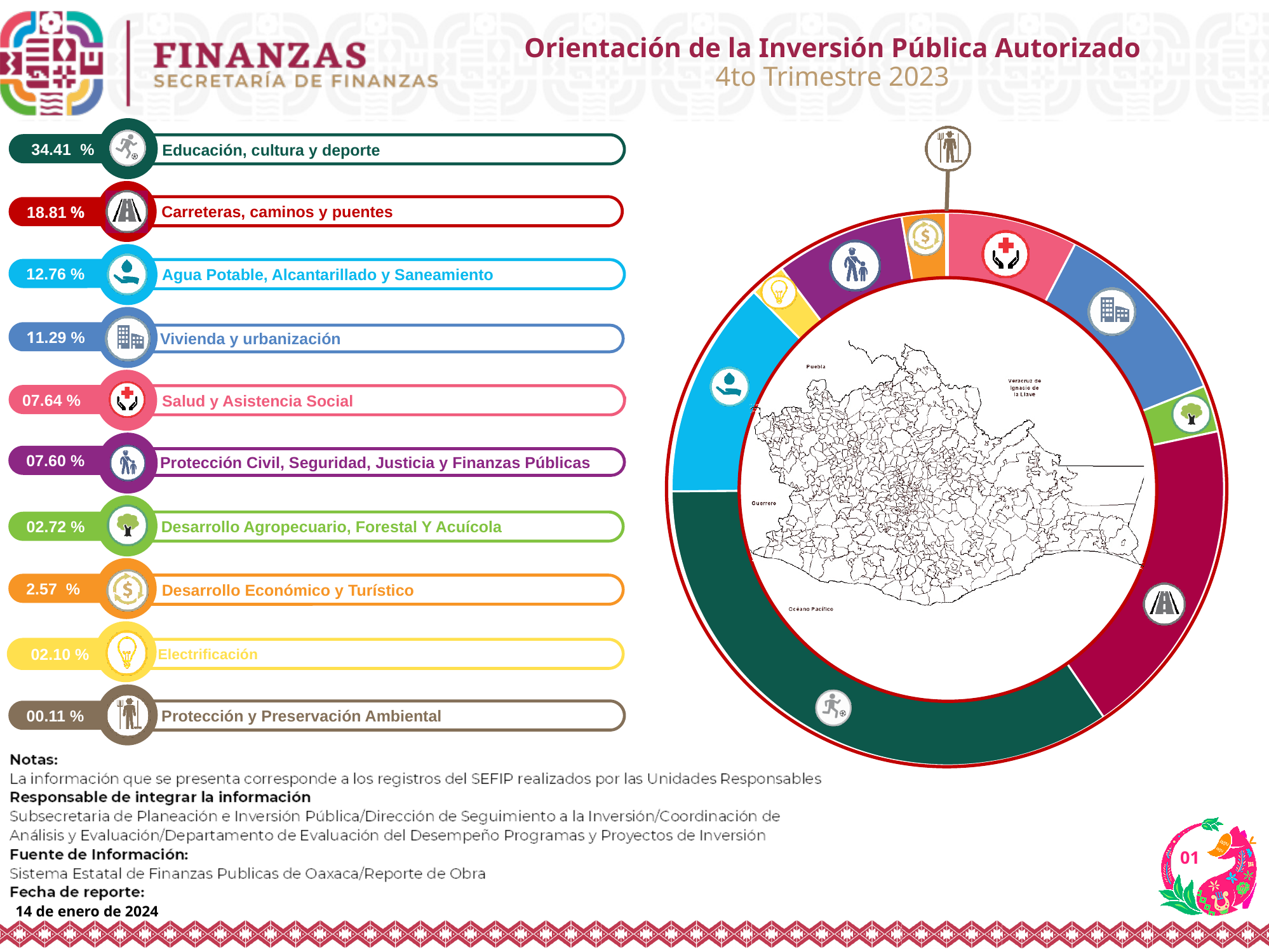
What percentage is shown for Agua Potable, Alcantarillado y Saneamiento? 12.76 % What percentage is shown for Vivienda y urbanización? 11.29 % Which category has the smallest share of the authorized public investment? Protección y Preservación Ambiental What is the title of the slide containing the chart? Orientación de la Inversión Pública Autorizado 4to Trimestre 2023 How many categories are shown in the chart? 10 What percentage is shown for Protección y Preservación Ambiental? 00.11 % Which has the larger share: Salud y Asistencia Social or Protección Civil, Seguridad, Justicia y Finanzas Públicas? Salud y Asistencia Social What percentage of the authorized public investment goes to Educación, cultura y deporte? 34.41 % What percentage is shown for Carreteras, caminos y puentes? 18.81 % Which category has the largest share of the authorized public investment? Educación, cultura y deporte What kind of chart is used to show the distribution of the authorized public investment? Donut (pie) chart What is the difference in percentage points between Educación, cultura y deporte and Carreteras, caminos y puentes? 15.60